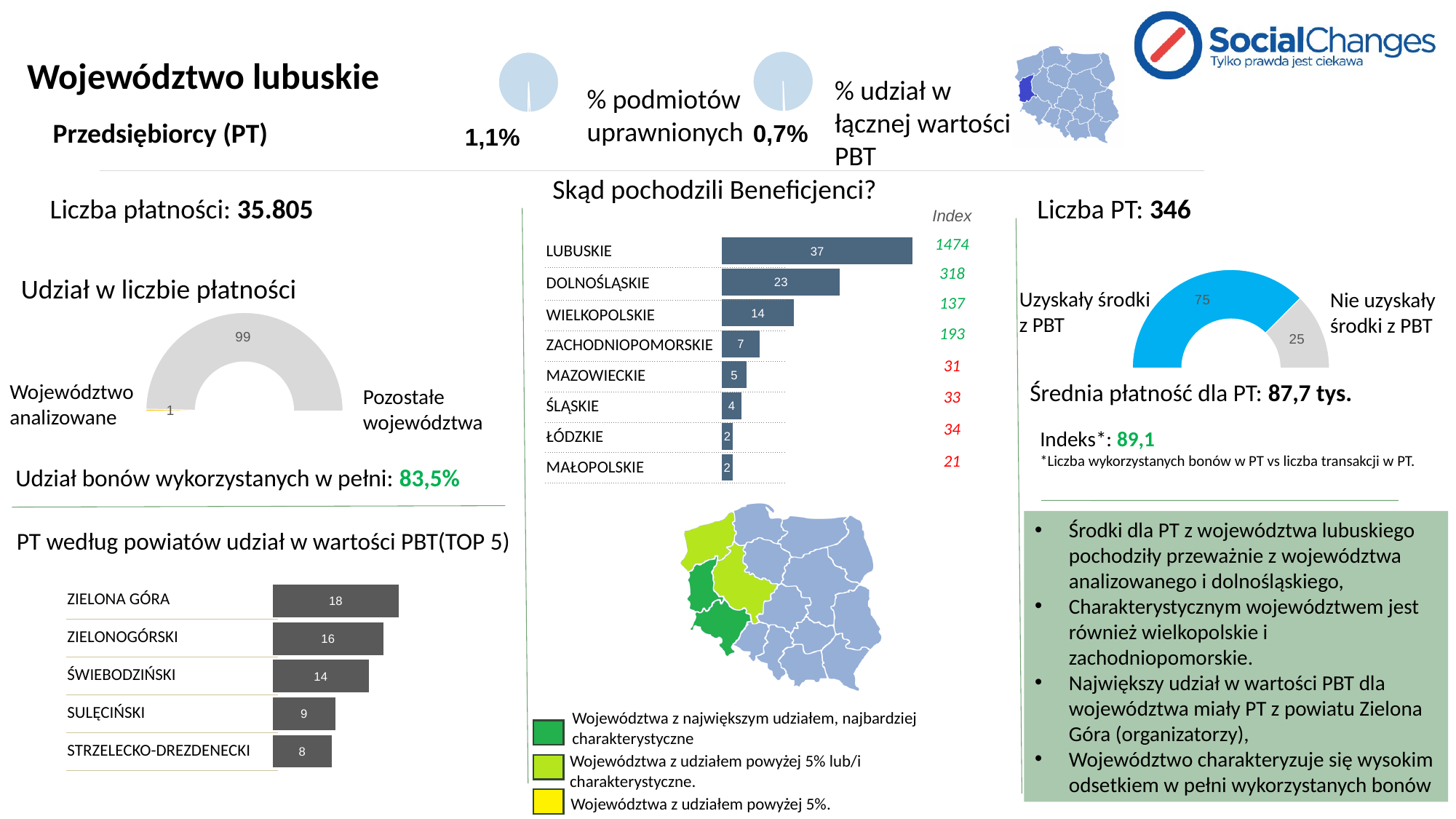
In the 'Skąd pochodzili Beneficjenci?' bar chart, how many categories are shown? 8 In the 'Skąd pochodzili Beneficjenci?' bar chart, what is the difference between LUBUSKIE and DOLNOŚLĄSKIE? 14 What kind of chart is 'PT według powiatów udział w wartości PBT(TOP 5)'? Bar chart In the 'Udział w liczbie płatności' gauge chart, what is the value for 'Pozostałe województwa'? 99 In the 'Skąd pochodzili Beneficjenci?' bar chart, what is the value for LUBUSKIE? 37 In the 'Skąd pochodzili Beneficjenci?' bar chart, what is the value for WIELKOPOLSKIE? 14 In the 'PT według powiatów udział w wartości PBT(TOP 5)' chart, what is the difference between ZIELONOGÓRSKI and SULĘCIŃSKI? 7 In the 'Liczba PT' gauge chart, what is the value for 'Uzyskały środki z PBT'? 75 In the 'PT według powiatów udział w wartości PBT(TOP 5)' chart, which category has the lowest value? STRZELECKO-DREZDENECKI In the 'PT według powiatów udział w wartości PBT(TOP 5)' chart, what is the value for ZIELONA GÓRA? 18 In the 'Skąd pochodzili Beneficjenci?' bar chart, which is larger: ZACHODNIOPOMORSKIE or MAZOWIECKIE? ZACHODNIOPOMORSKIE In the 'Skąd pochodzili Beneficjenci?' bar chart, which category has the highest value? LUBUSKIE